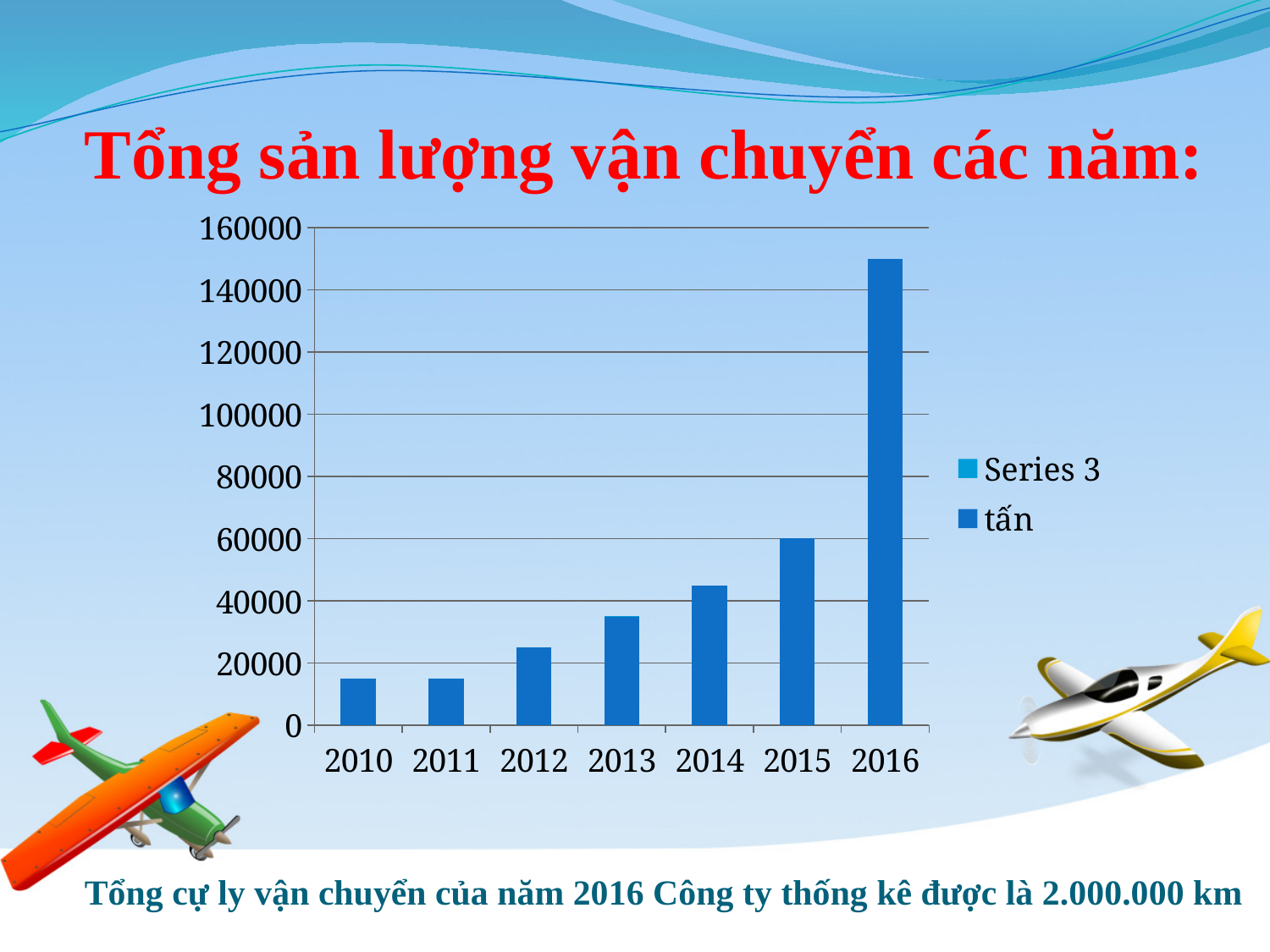
Is the value for 2013 greater or less than 40000? less Is the value for 2014 greater or less than 40000? greater Which year has the larger value, 2014 or 2015? 2015 How many years are shown on the x axis of the chart? 7 Is the value for 2010 greater or less than 20000? less What kind of chart is shown on the slide? bar chart Do the values generally rise or fall from 2010 to 2016? rise How many series does the chart legend list? 2 Which year has the highest value in the chart? 2016 What is the title of the chart on the slide? Tổng sản lượng vận chuyển các năm: